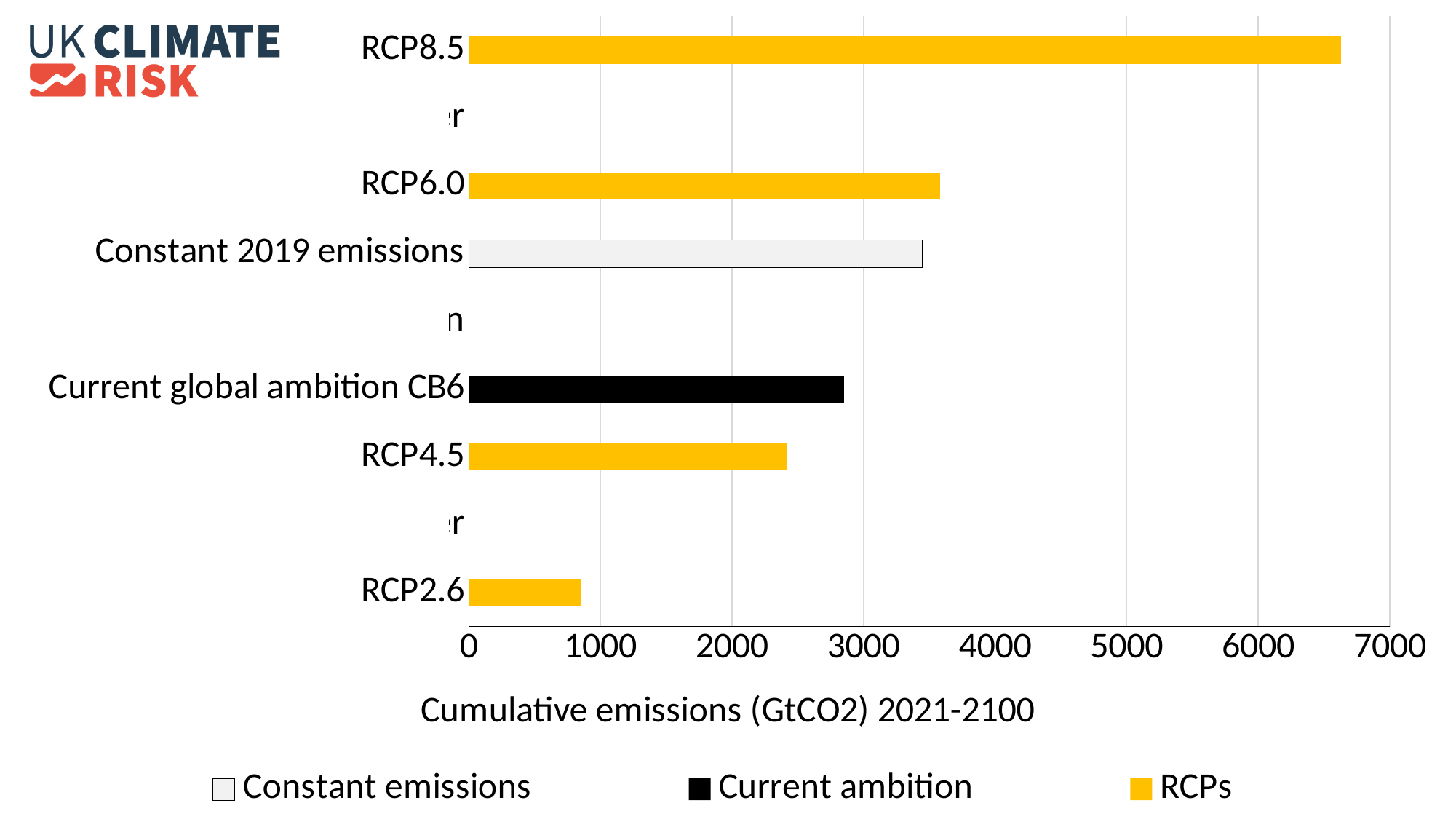
Is the value for RCP2.6 greater or less than 1000? less Is the value for Constant 2019 emissions greater or less than 3000? greater Which category has the lowest cumulative emissions? RCP2.6 Which category has the highest cumulative emissions? RCP8.5 What is the title of the horizontal axis? Cumulative emissions (GtCO2) 2021-2100 Is the value for RCP8.5 greater or less than 6000? greater What kind of chart is shown on the slide? bar chart How many series does the legend list? 3 Which is larger, the value for RCP6.0 or the value for RCP4.5? RCP6.0